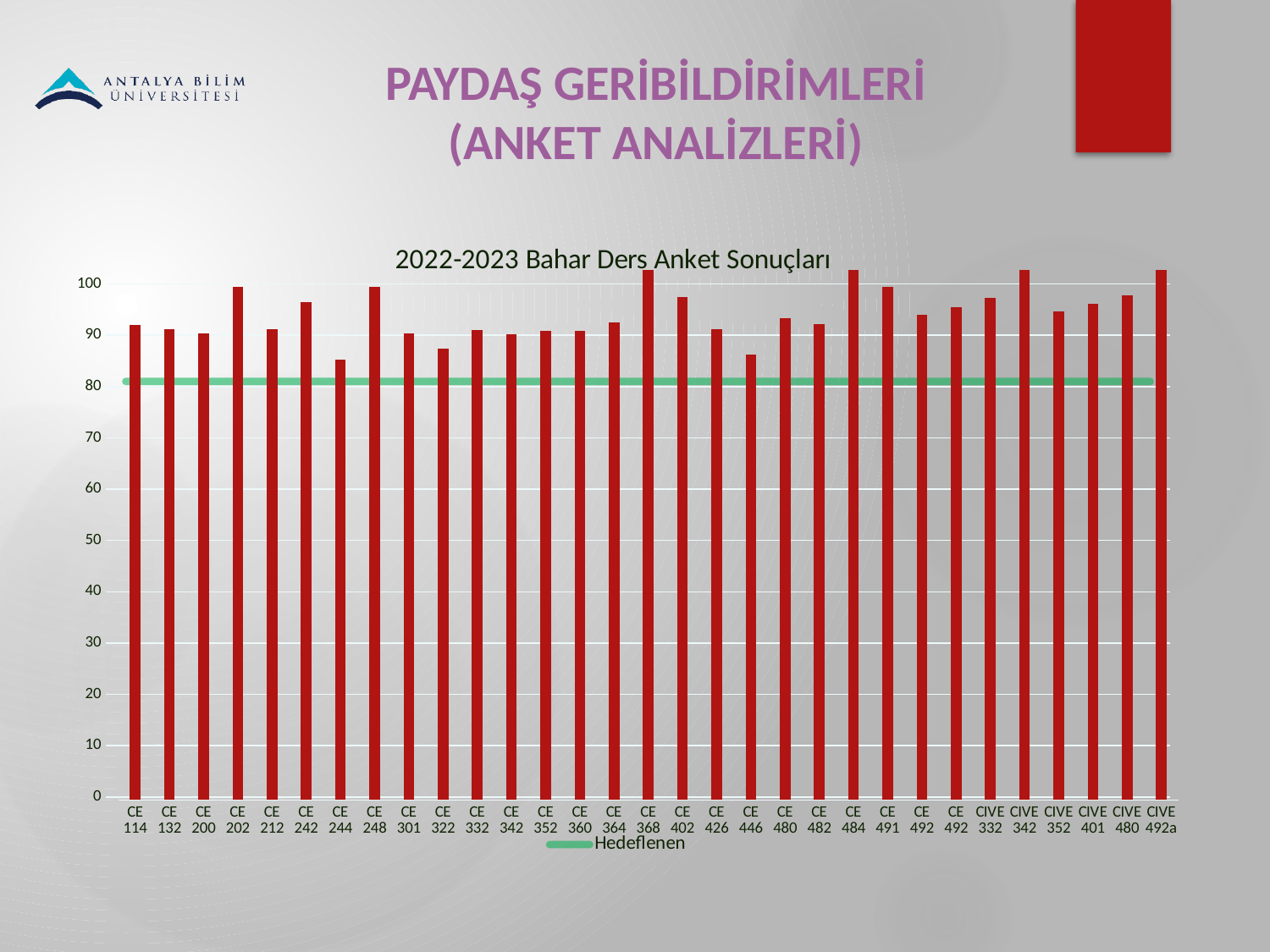
Is the value for CE 322 greater or less than 90? less Is the value for CE 446 greater or less than 90? less Is the value for CE 202 greater or less than 90? greater Which has the larger value, CE 248 or CE 322? CE 248 What kind of chart is shown on the slide? bar chart Which has the larger value, CE 484 or CE 446? CE 484 What is the title of the chart? 2022-2023 Bahar Ders Anket Sonuçları How many bars (courses) are plotted in the chart? 31 Which has the larger value, CE 202 or CE 244? CE 202 What entry does the chart legend list? Hedeflenen